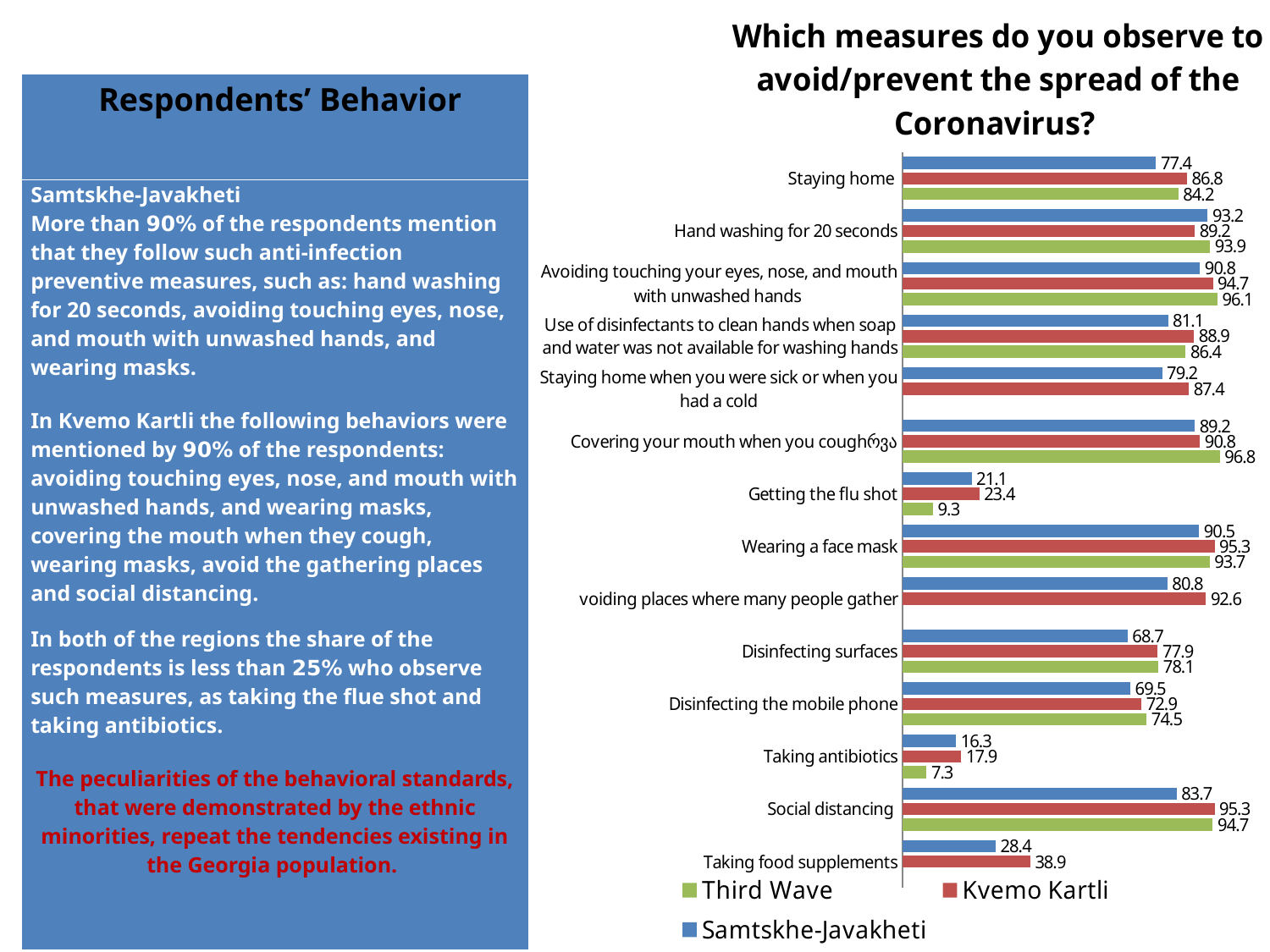
Which category has the highest Third Wave value? Covering your mouth when you cough For Wearing a face mask, which is larger: the Kvemo Kartli value or the Samtskhe-Javakheti value? Kvemo Kartli Which category has the lowest Samtskhe-Javakheti value? Taking antibiotics What is the Third Wave value for Getting the flu shot? 9.3 What is the title of the chart? Which measures do you observe to avoid/prevent the spread of the Coronavirus? What is the difference between the Kvemo Kartli and Samtskhe-Javakheti values for Social distancing? 11.6 What is the Kvemo Kartli value for Taking food supplements? 38.9 What kind of chart is shown on the slide? Bar chart What is the Samtskhe-Javakheti value for Social distancing? 83.7 How many series does the chart legend list? 3 How many categories are shown on the chart? 14 What is the Kvemo Kartli value for Staying home? 86.8